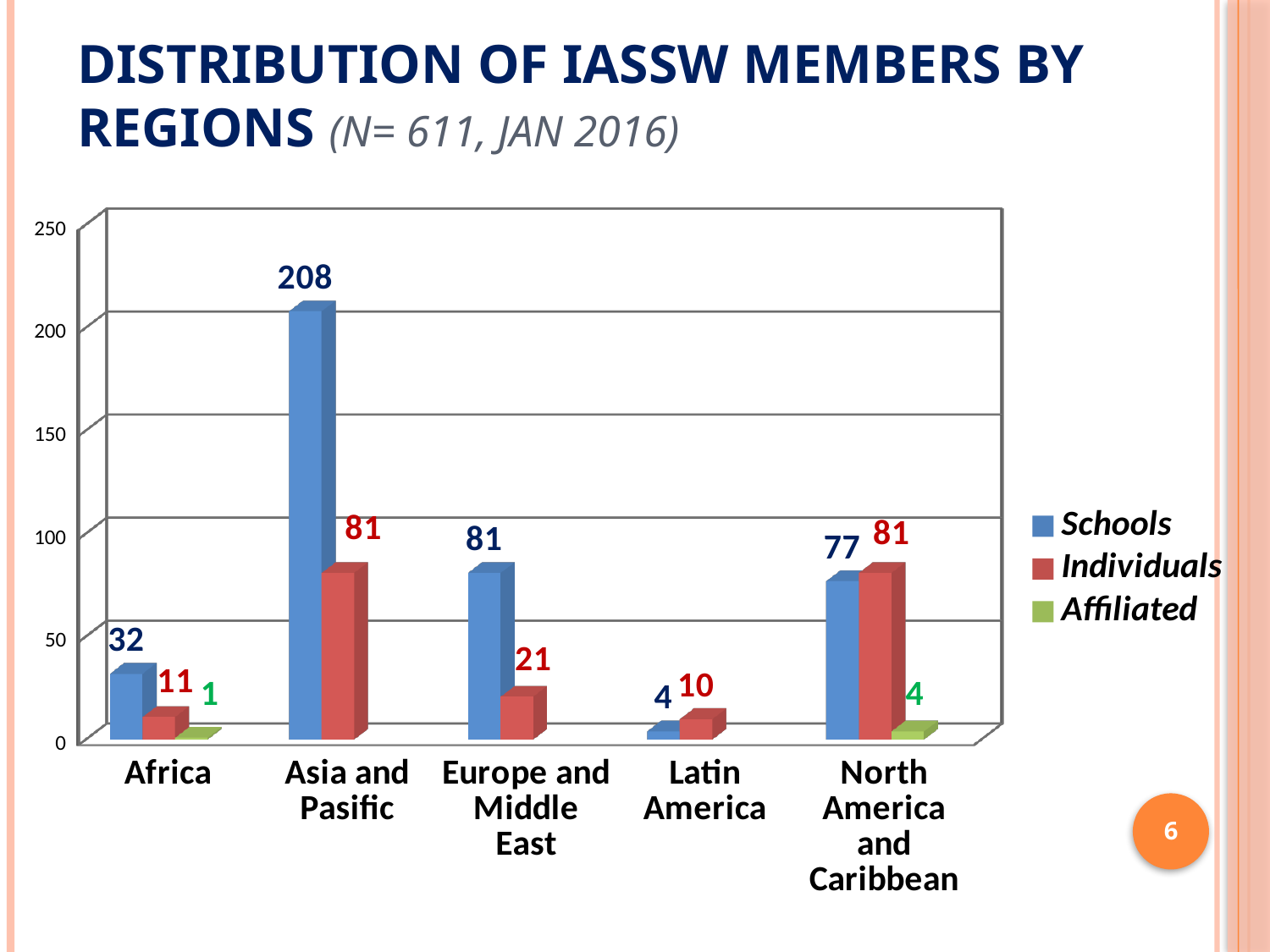
How many series does the legend list? 3 Which is larger in Africa, Schools or Individuals? Schools Which region has the lowest value for Individuals? Latin America What kind of chart is shown on the slide? bar chart What is the value for Individuals in Europe and Middle East? 21 How many regions are shown on the x axis? 5 What colour are the Individuals bars? red Is the value for Schools in Asia and Pasific greater or less than 200? greater Which region has the highest value for Schools? Asia and Pasific What is the value for Schools in Asia and Pasific? 208 What is the difference between Schools in Asia and Pasific and Schools in Europe and Middle East? 127 What is the value for Affiliated in North America and Caribbean? 4